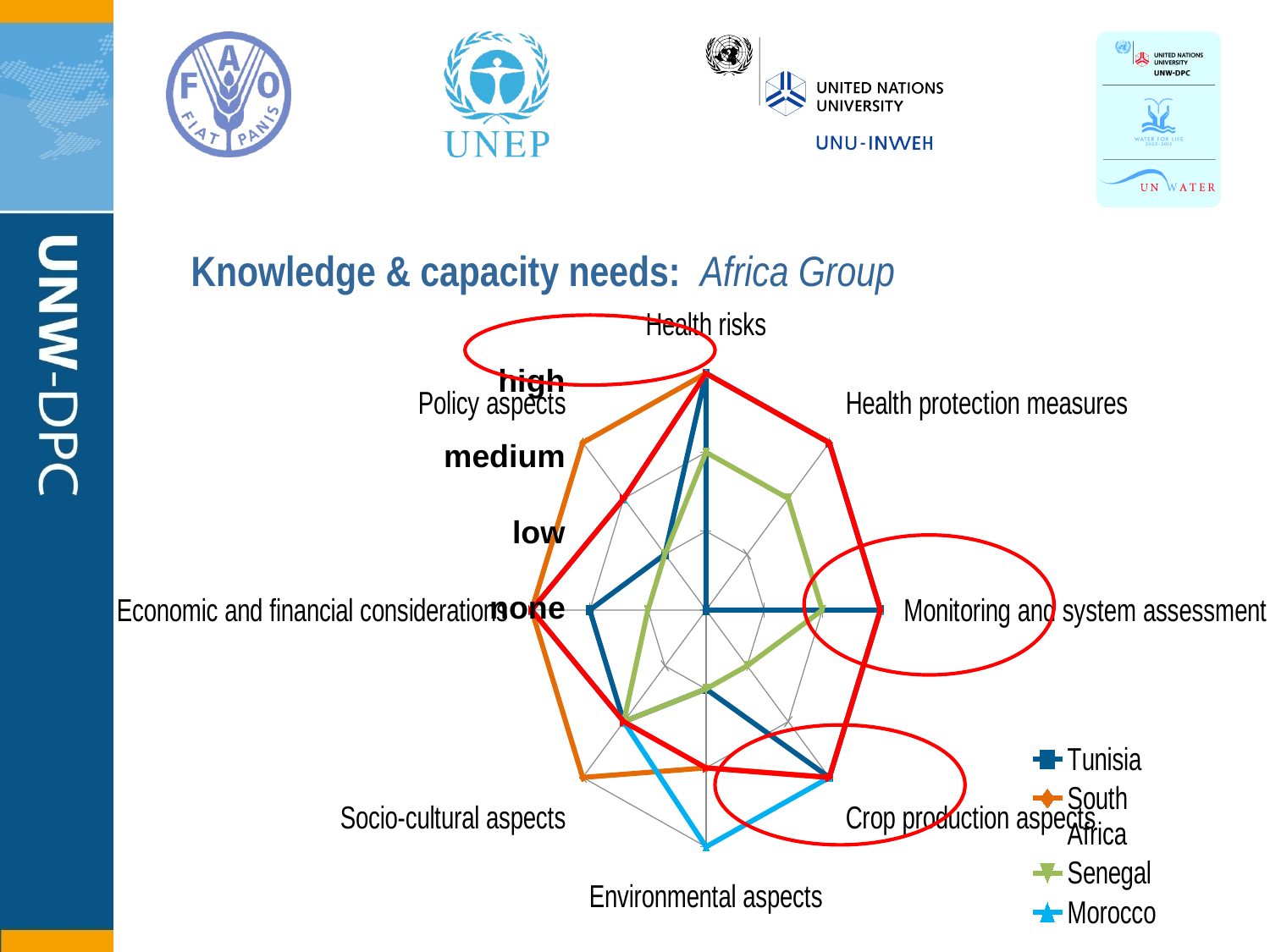
How many series does the legend list? 4 Which category is plotted at the bottom of the radar chart? Environmental aspects What is the lowest level label shown on the chart's scale? none What is the highest level label shown on the chart's scale? high Which category is plotted on the far left of the radar chart? Economic and financial considerations Which category is plotted at the top of the radar chart? Health risks What is the title of the chart on the slide? Knowledge & capacity needs: Africa Group Which series is listed last in the legend? Morocco Which category is plotted on the far right of the radar chart? Monitoring and system assessment How many categories (axes) does the radar chart have? 8 What kind of chart is shown on the slide? Radar chart